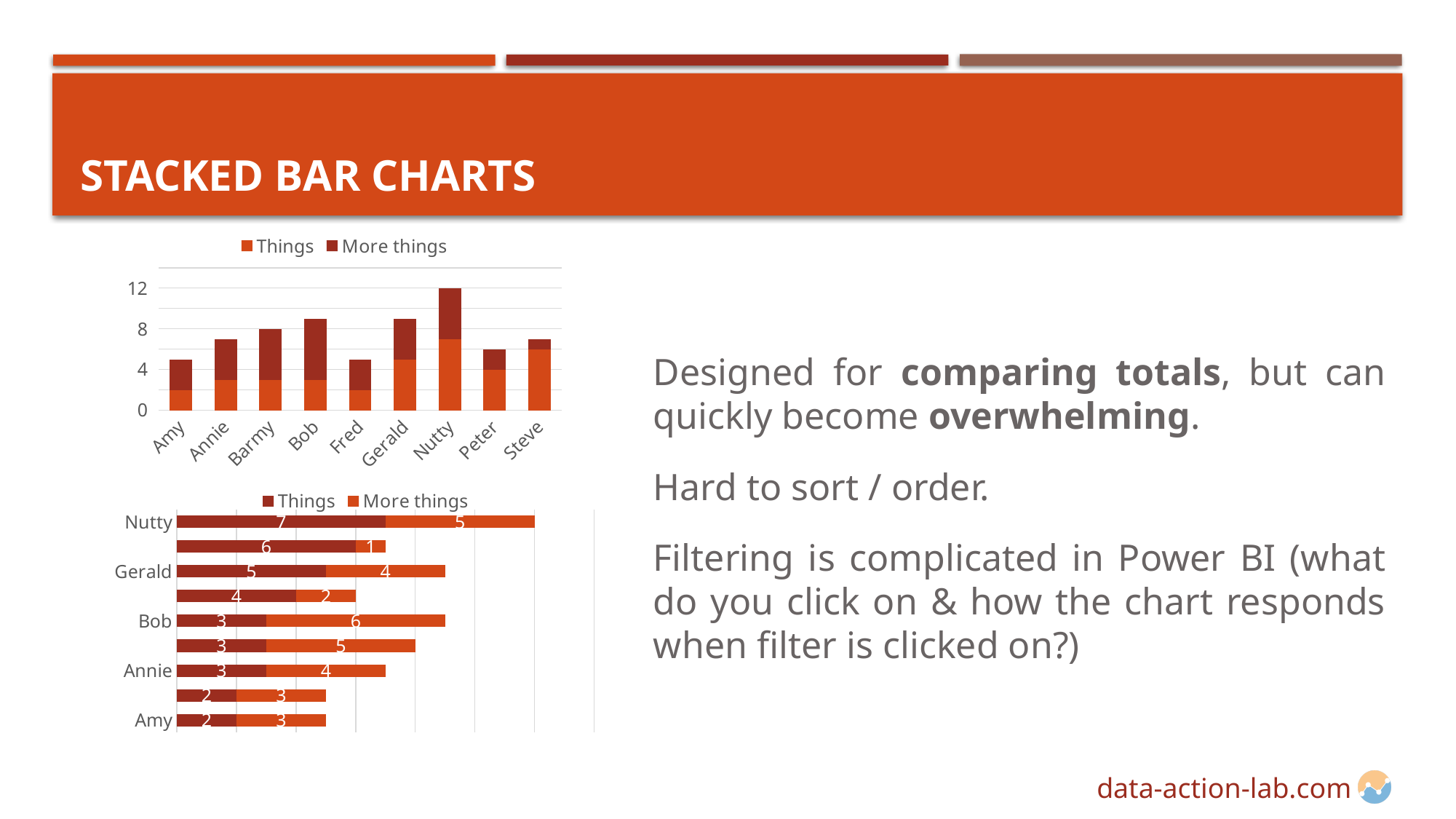
In the bottom chart, what is the Things value for Nutty? 7 In the bottom chart, what is the difference between the More things value and the Things value for Bob? 3 In the top chart, which category has the tallest stacked bar? Nutty In the top chart, is the total for Fred greater or less than 8? less In the bottom chart, which is larger: the Things value for Nutty or the Things value for Gerald? Nutty How many categories are shown on the x axis of the top chart? 9 In the bottom chart, what is the More things value for Gerald? 4 In the bottom chart, what is the total of the stacked bar for Nutty? 12 In the top chart, is the total for Amy greater or less than 8? less What kind of chart is the top chart on the slide? bar chart How many series does the legend of the top chart list? 2 In the bottom chart, what is the total of the stacked bar for Amy? 5